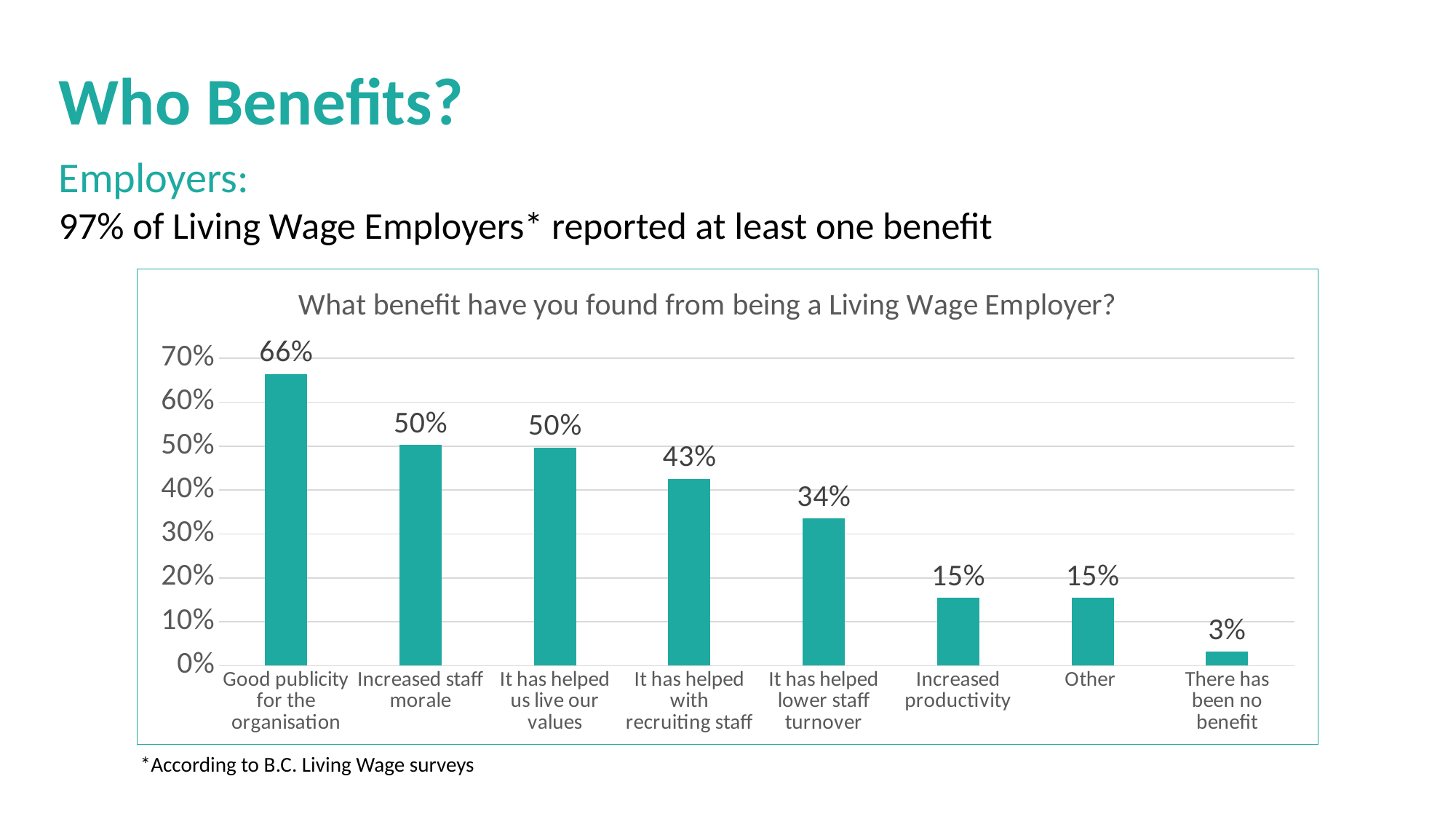
Which benefit category has the highest value? Good publicity for the organisation What percentage of employers reported 'Good publicity for the organisation' as a benefit? 66% Which is larger: 'It has helped with recruiting staff' or 'It has helped lower staff turnover'? It has helped with recruiting staff What is the difference between 'Increased productivity' and 'There has been no benefit'? 12% Which category has the lowest value? There has been no benefit What is the difference between 'Good publicity for the organisation' and 'Increased staff morale'? 16% What percentage is shown for 'It has helped lower staff turnover'? 34% How many categories are shown on the x axis of the chart? 8 What is the title of the chart? What benefit have you found from being a Living Wage Employer? What type of chart is shown on the slide? Bar chart Do the values rise or fall from left to right along the x axis? Fall What value is shown for 'It has helped with recruiting staff'? 43%